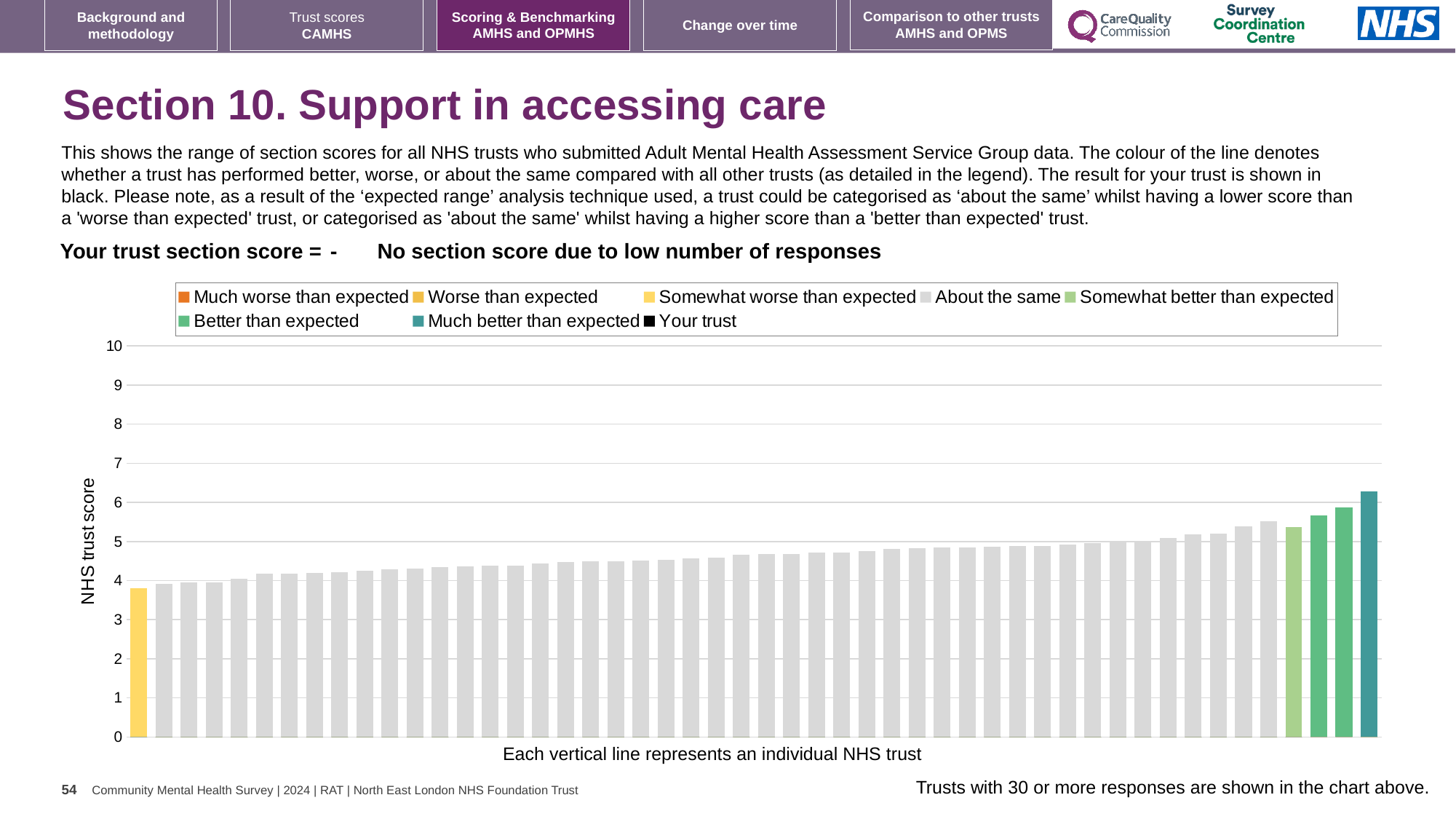
How many entries does the chart legend list? 8 Which legend category does the lowest bar in the chart belong to? Somewhat worse than expected Which legend category does the highest bar in the chart belong to? Much better than expected Do the bar values rise or fall from left to right along the x axis? rise Which bar has the highest value: the leftmost bar or the rightmost bar? the rightmost bar How many bars in the chart are coloured yellow? 1 What kind of chart is shown on the slide? bar chart Are all of the bars in the chart greater or less than 7? less Is the value of the tallest bar (the rightmost, teal bar) greater or less than 6? greater Is the value of the leftmost (yellow) bar greater or less than 4? less What is the label on the vertical axis of the chart? NHS trust score